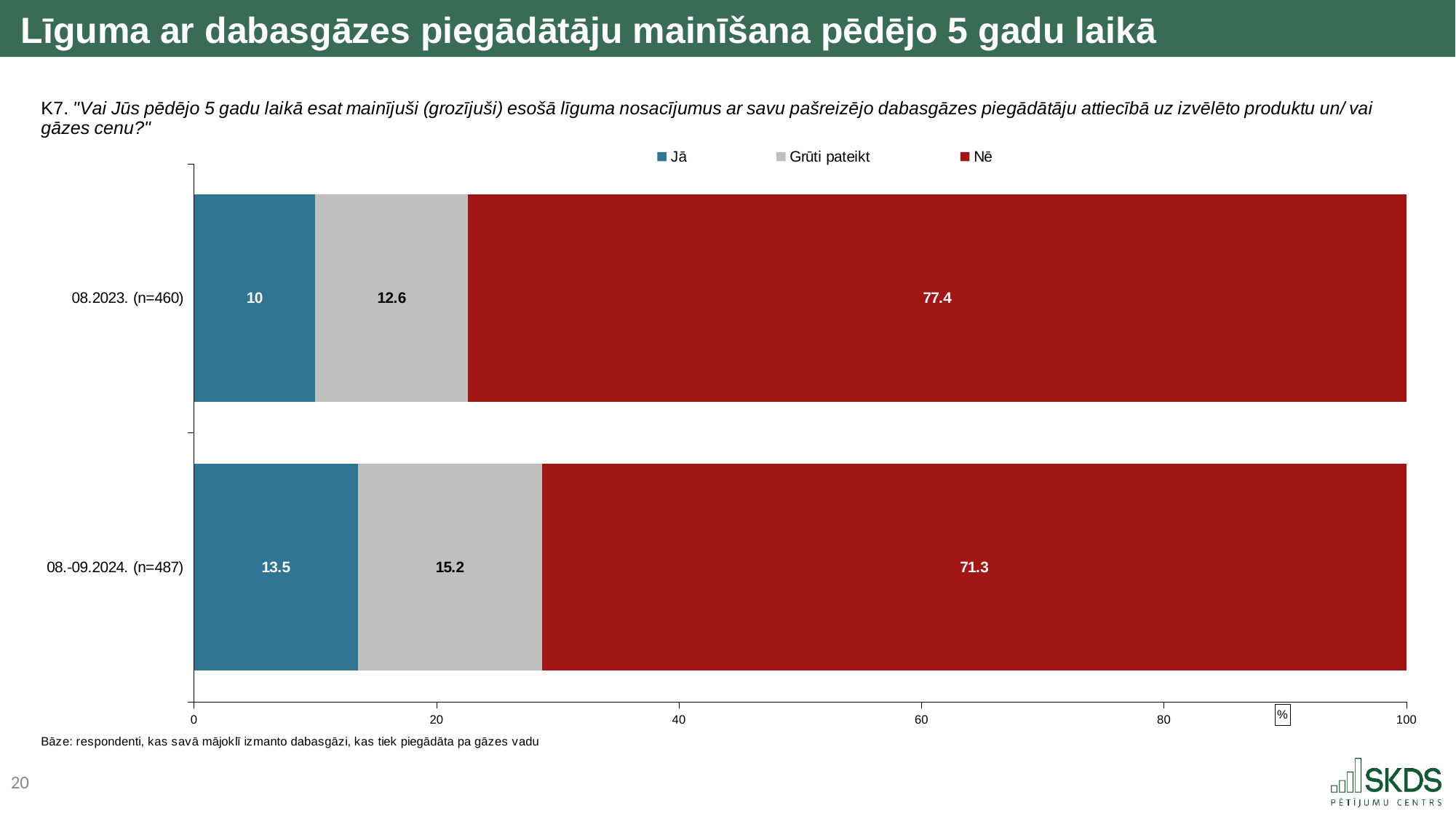
How many series does the legend list? 3 What is the value for "Grūti pateikt" in 08.-09.2024. (n=487)? 15.2 Which category has the lowest value for "Jā"? 08.2023. (n=460) What is the value for "Jā" in 08.2023. (n=460)? 10 How many categories are shown on the y axis? 2 What is the difference between the "Nē" values for 08.2023. (n=460) and 08.-09.2024. (n=487)? 6.1 What is the value for "Nē" in 08.-09.2024. (n=487)? 71.3 Is the "Jā" value larger in 08.2023. (n=460) or in 08.-09.2024. (n=487)? 08.-09.2024. (n=487) What is the total of the stacked bar for 08.-09.2024. (n=487)? 100 Which series is shown in red? Nē Which category has the highest value for "Nē"? 08.2023. (n=460) What kind of chart is shown on the slide? Stacked bar chart